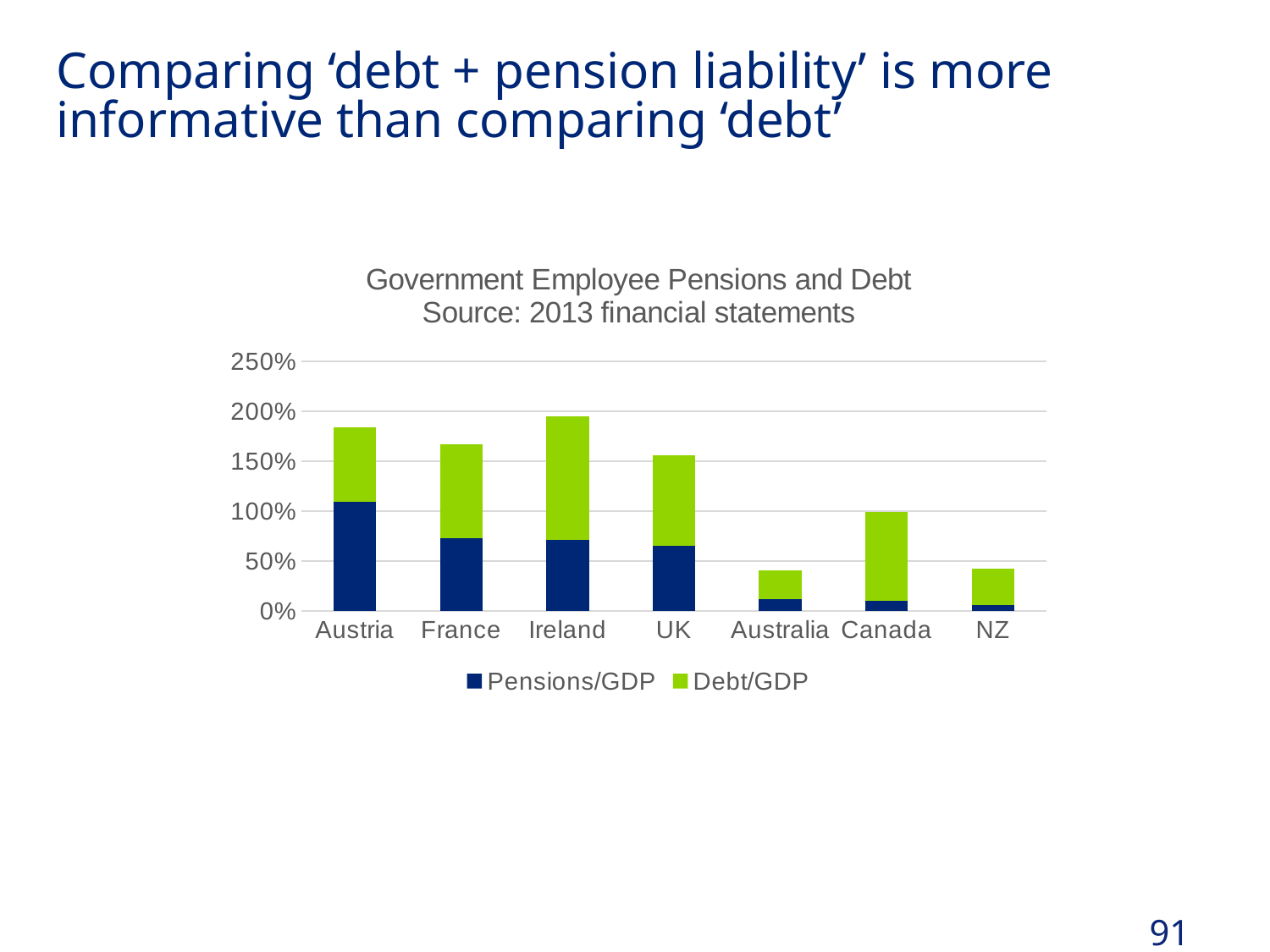
Is the combined stacked bar for Austria greater or less than 150%? greater Is the Pensions/GDP value for Austria greater or less than 100%? greater What is the title of the chart? Government Employee Pensions and Debt Source: 2013 financial statements Which country has the lowest Pensions/GDP value? NZ How many series does the chart's legend list? 2 Is the combined stacked bar for Australia greater or less than 50%? less Which country has the highest Pensions/GDP value? Austria What kind of chart is shown on the slide? Stacked bar chart Which has the larger Pensions/GDP value, Austria or France? Austria Which country has the taller stacked bar, Canada or Australia? Canada How many countries are shown on the x axis of the chart? 7 Which country has the tallest stacked bar (highest combined Pensions/GDP and Debt/GDP)? Ireland